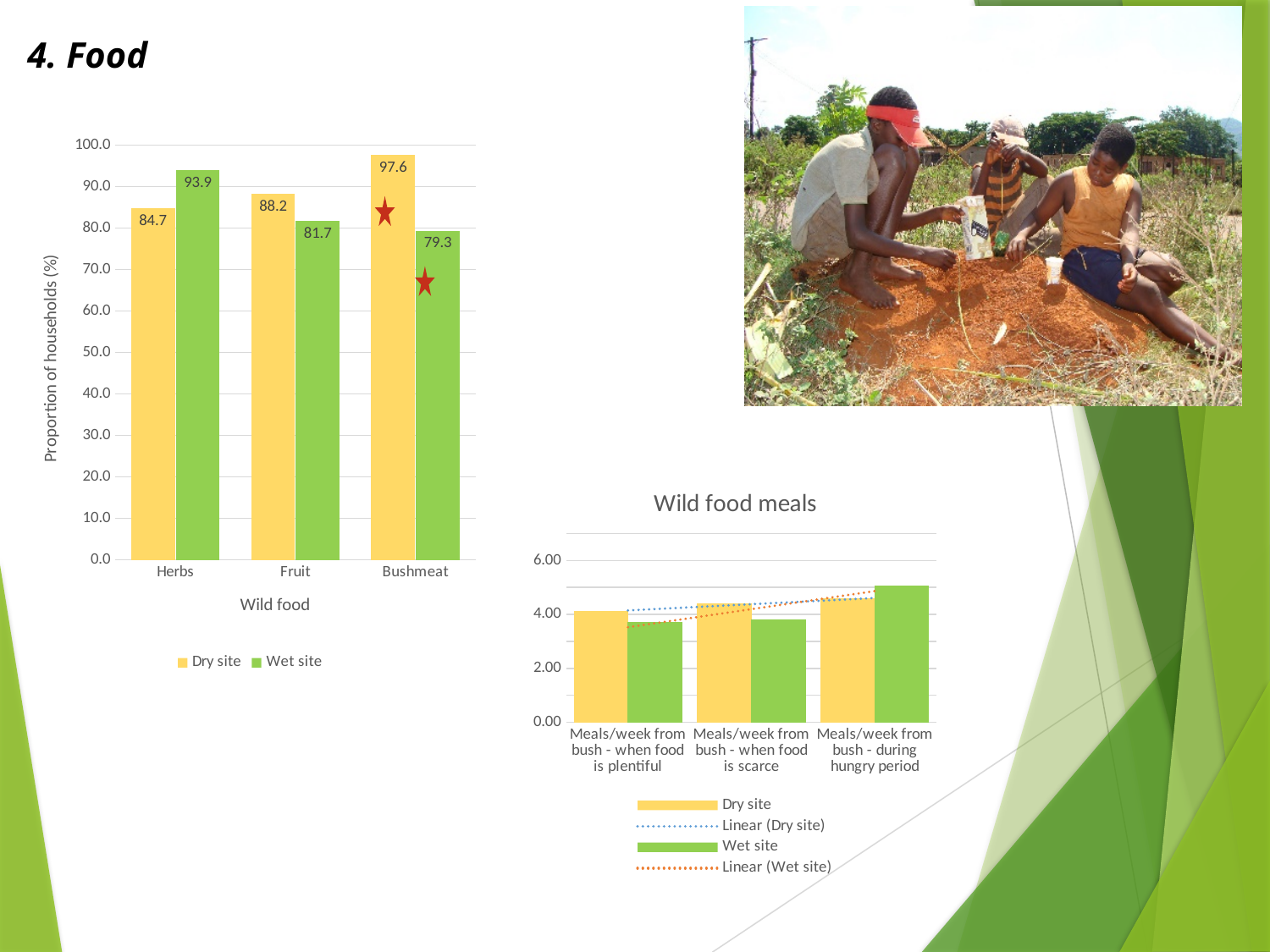
In the left chart (Proportion of households), what is the Dry site value for Bushmeat? 97.6 In the left chart (Proportion of households), what is the y-axis label? Proportion of households (%) In the left chart (Proportion of households), which wild food has the lowest Wet site value? Bushmeat In the 'Wild food meals' chart, is the Wet site value for 'Meals/week from bush - when food is plentiful' greater or less than 4.00? less In the left chart (Proportion of households), what is the Wet site value for Fruit? 81.7 In the 'Wild food meals' chart, is the Wet site value for 'Meals/week from bush - during hungry period' greater or less than 4.00? greater In the left chart (Proportion of households), which wild food has the highest Dry site value? Bushmeat In the left chart (Proportion of households), what is the difference between the Dry site and Wet site values for Bushmeat? 18.3 In the left chart (Proportion of households), which is larger for Herbs, the Dry site or the Wet site value? Wet site In the 'Wild food meals' chart, how many entries does the legend list? 4 In the left chart (Proportion of households), what is the Wet site value for Herbs? 93.9 In the left chart (Proportion of households), how many wild food categories are shown on the x axis? 3